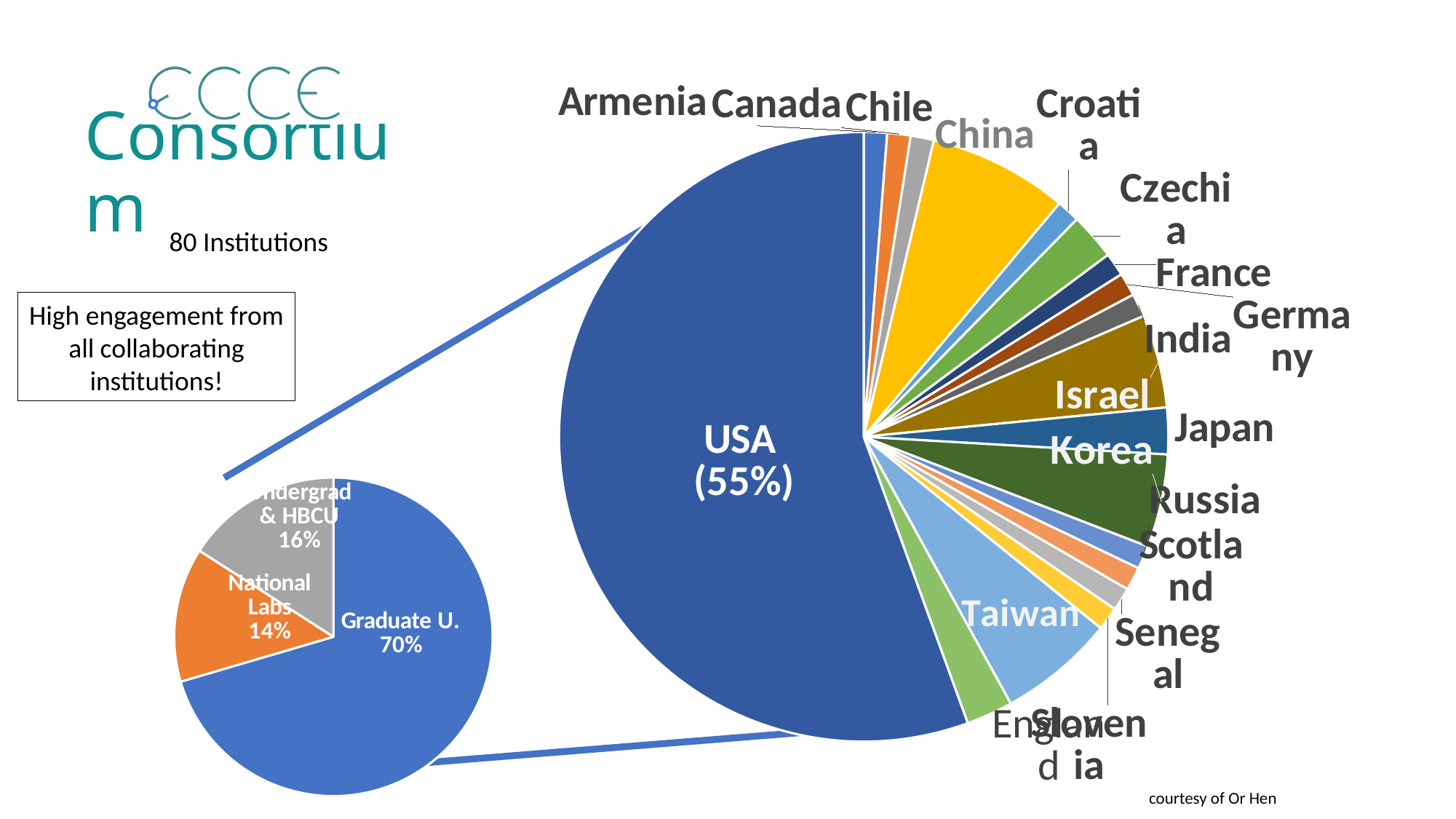
In the large country pie chart, which slice is larger, Taiwan or Armenia? Taiwan What kind of chart is the large chart showing countries? pie chart How many institutions does the slide say are in the consortium? 80 Institutions In the small pie chart at the bottom left, what share is Graduate U.? 70% In the small pie chart at the bottom left, how many categories are shown? 3 In the small pie chart at the bottom left, which category has the largest share? Graduate U. In the small pie chart at the bottom left, what share is Undergrad & HBCU? 16% In the small pie chart at the bottom left, which category has the smallest share? National Labs In the large country pie chart, what share does USA have? 55% In the small pie chart at the bottom left, what is the difference between the Graduate U. share and the National Labs share? 56 percentage points In the large country pie chart, which country has the largest slice? USA In the small pie chart at the bottom left, what share is National Labs? 14%